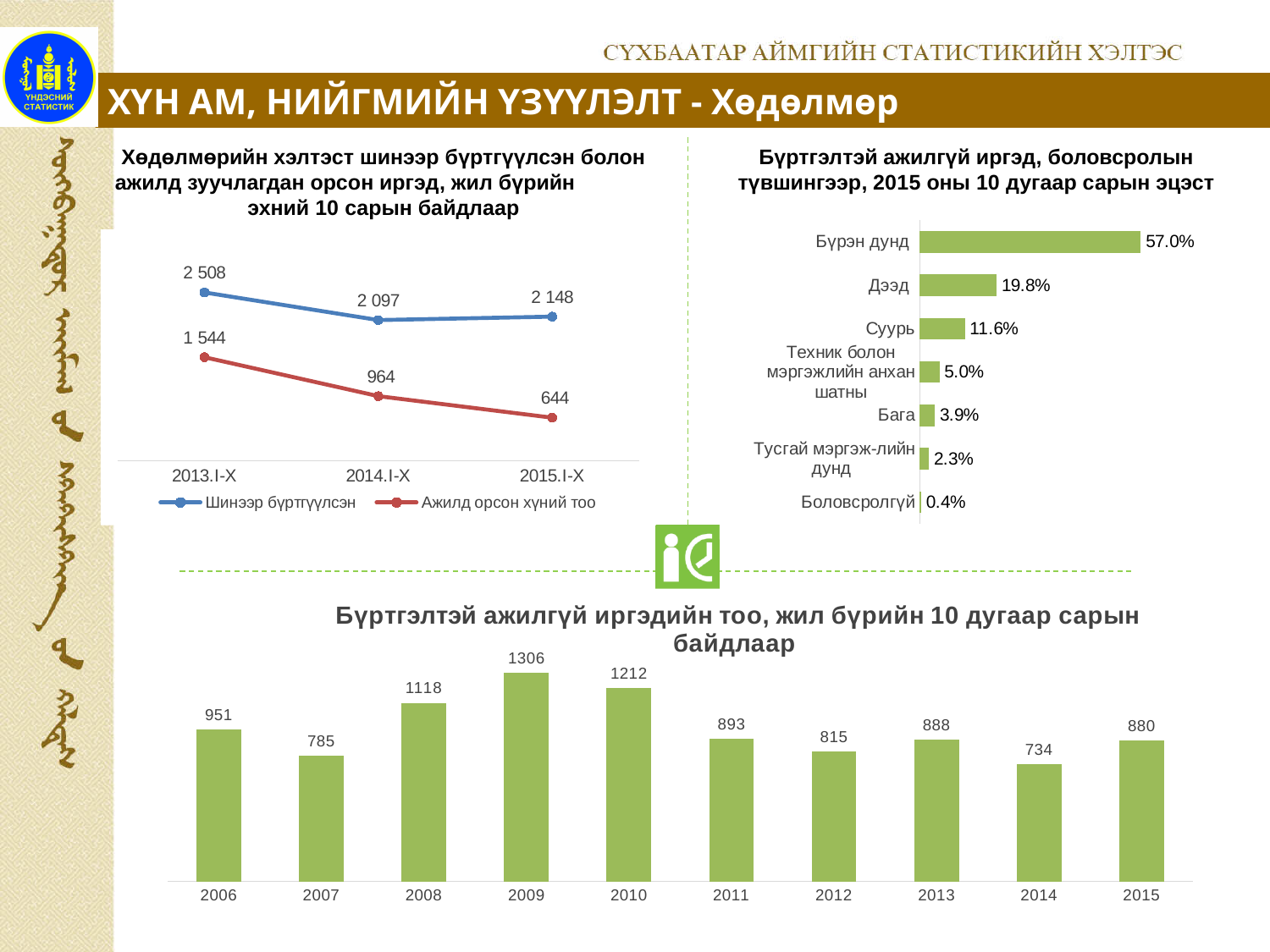
In the top-right chart, which category has the lowest value? Боловсролгүй In the top-right chart, what is the value for 'Дээд'? 19.8% In the top-left line chart, what is the difference between 'Шинээр бүртгүүлсэн' and 'Ажилд орсон хүний тоо' in 2014.I-X? 1 133 What kind of chart is the bottom chart? bar chart In the top-left line chart, does the 'Ажилд орсон хүний тоо' series rise or fall from 2013.I-X to 2015.I-X? fall In the top-left line chart, how many series does the legend list? 2 In the top-right chart, which category has the highest value? Бүрэн дунд In the top-left line chart, what is the value for 'Ажилд орсон хүний тоо' in 2015.I-X? 644 In the top-left line chart, what is the value for 'Шинээр бүртгүүлсэн' in 2013.I-X? 2 508 In the bottom chart, which year has the lowest value? 2014 In the bottom chart, what is the value for 2009? 1306 In the top-right chart, how many categories are shown? 7